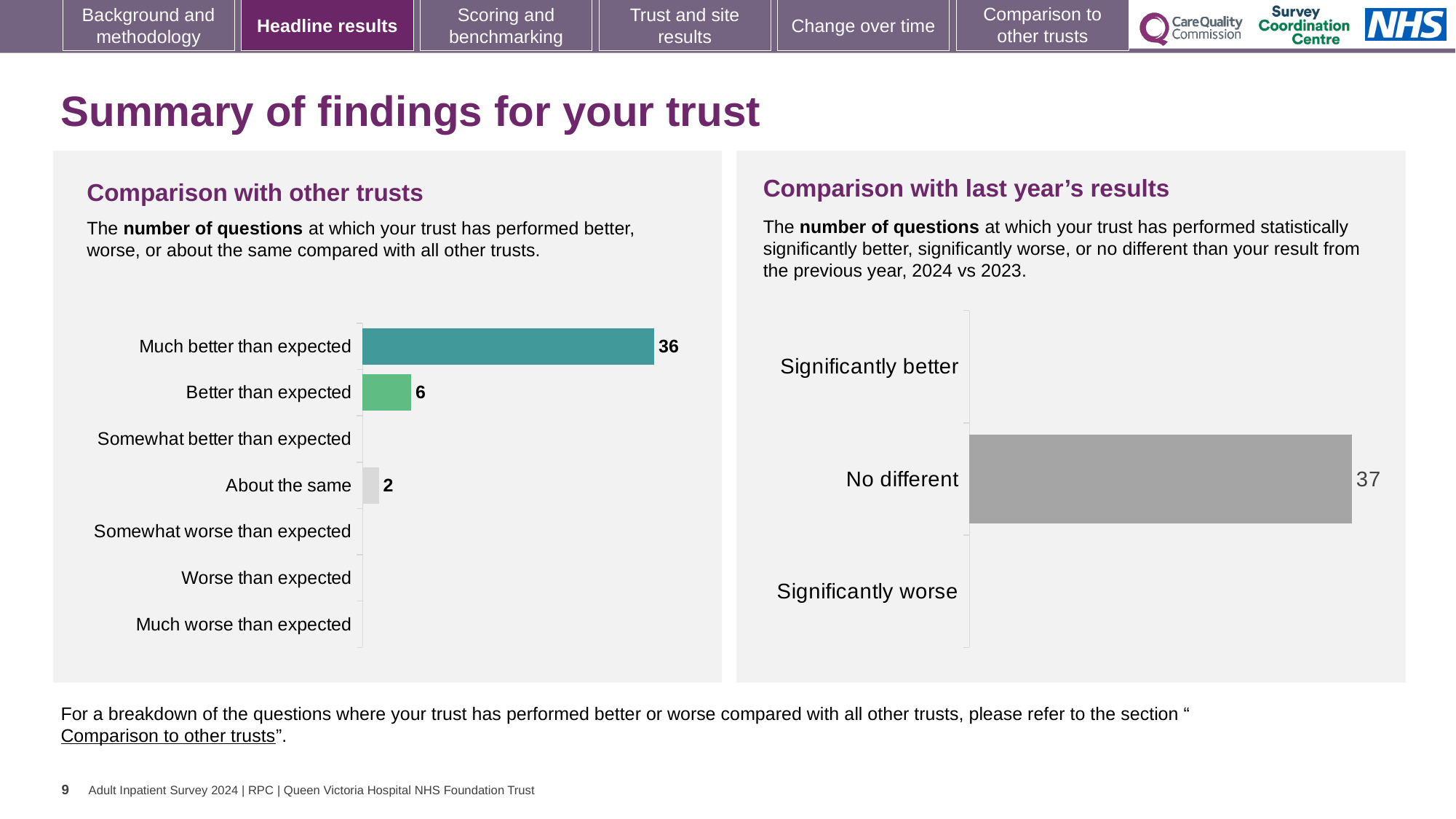
In the 'Comparison with other trusts' chart, which is larger: 'Better than expected' or 'About the same'? Better than expected In the 'Comparison with other trusts' chart, which category has the highest value? Much better than expected In the 'Comparison with other trusts' chart, what is the value for 'Better than expected'? 6 In the 'Comparison with other trusts' chart, what is the difference between 'Much better than expected' and 'Better than expected'? 30 In the 'Comparison with last year's results' chart, which category has the highest value? No different In the 'Comparison with other trusts' chart, what colour is the bar for 'Much better than expected'? Teal In the 'Comparison with other trusts' chart, what is the value for 'Much better than expected'? 36 How many categories are listed on the y axis of the 'Comparison with other trusts' chart? 7 What kind of chart is the 'Comparison with other trusts' chart? Bar chart In the 'Comparison with other trusts' chart, what is the value for 'About the same'? 2 In the 'Comparison with last year's results' chart, what is the value for 'No different'? 37 How many categories are listed on the y axis of the 'Comparison with last year's results' chart? 3